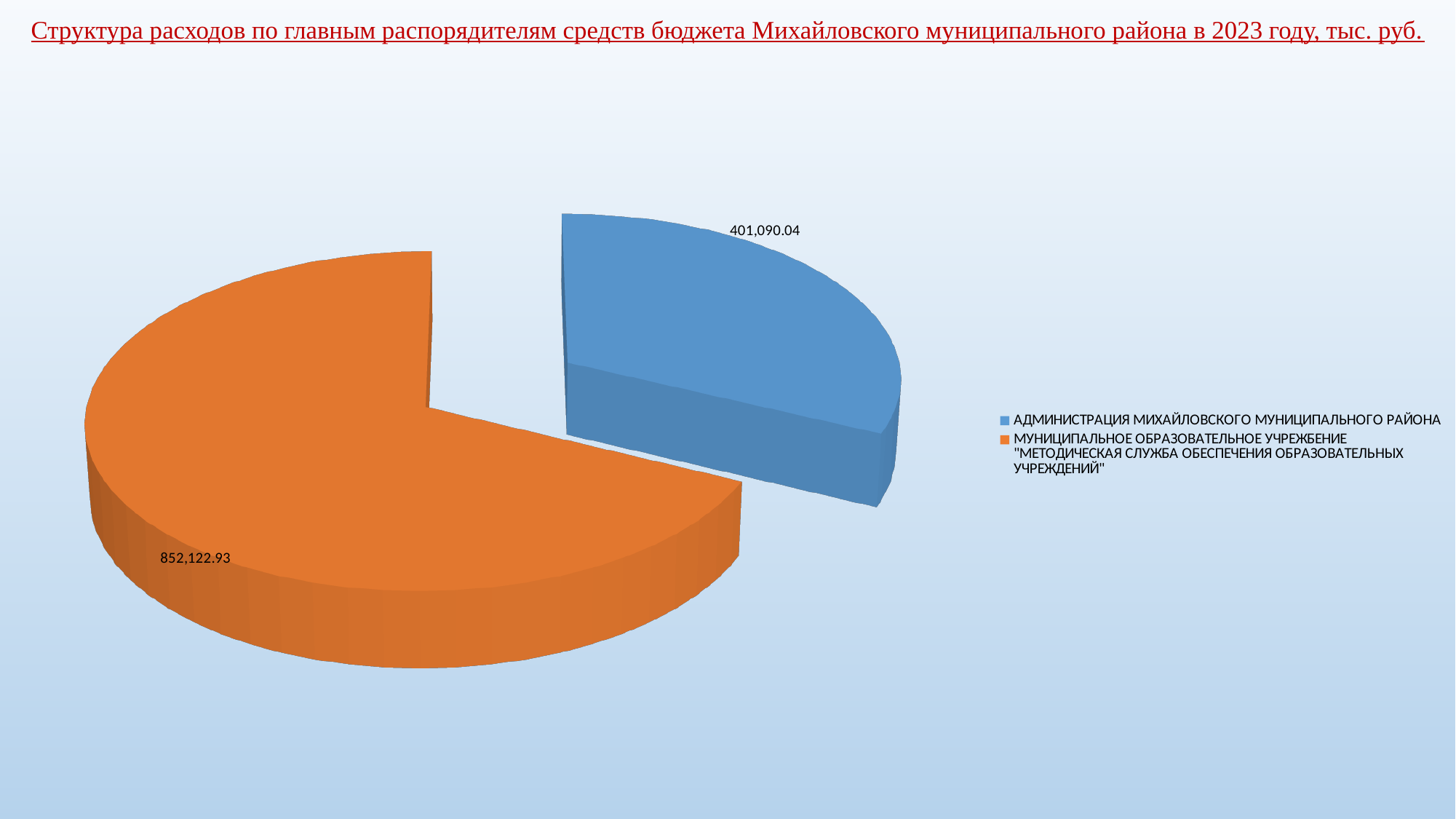
Which category has the largest slice of the pie? МУНИЦИПАЛЬНОЕ ОБРАЗОВАТЕЛЬНОЕ УЧРЕЖБЕНИЕ "МЕТОДИЧЕСКАЯ СЛУЖБА ОБЕСПЕЧЕНИЯ ОБРАЗОВАТЕЛЬНЫХ УЧРЕЖДЕНИЙ" What is the total of the two values shown on the pie chart? 1,253,212.97 What is the difference between the value for the orange slice and the value for the blue slice? 451,032.89 What is the value for АДМИНИСТРАЦИЯ МИХАЙЛОВСКОГО МУНИЦИПАЛЬНОГО РАЙОНА? 401,090.04 What is the value for МУНИЦИПАЛЬНОЕ ОБРАЗОВАТЕЛЬНОЕ УЧРЕЖБЕНИЕ "МЕТОДИЧЕСКАЯ СЛУЖБА ОБЕСПЕЧЕНИЯ ОБРАЗОВАТЕЛЬНЫХ УЧРЕЖДЕНИЙ"? 852,122.93 What year does the chart title say the expenditure structure refers to? 2023 Which is larger: the value for АДМИНИСТРАЦИЯ МИХАЙЛОВСКОГО МУНИЦИПАЛЬНОГО РАЙОНА or the value for the МУНИЦИПАЛЬНОЕ ОБРАЗОВАТЕЛЬНОЕ УЧРЕЖБЕНИЕ? МУНИЦИПАЛЬНОЕ ОБРАЗОВАТЕЛЬНОЕ УЧРЕЖБЕНИЕ How many entries does the legend list? 2 What colour is the slice for АДМИНИСТРАЦИЯ МИХАЙЛОВСКОГО МУНИЦИПАЛЬНОГО РАЙОНА? Blue Which category has the smallest slice of the pie? АДМИНИСТРАЦИЯ МИХАЙЛОВСКОГО МУНИЦИПАЛЬНОГО РАЙОНА How many slices does the pie chart have? 2 What type of chart is shown on the slide? Pie chart